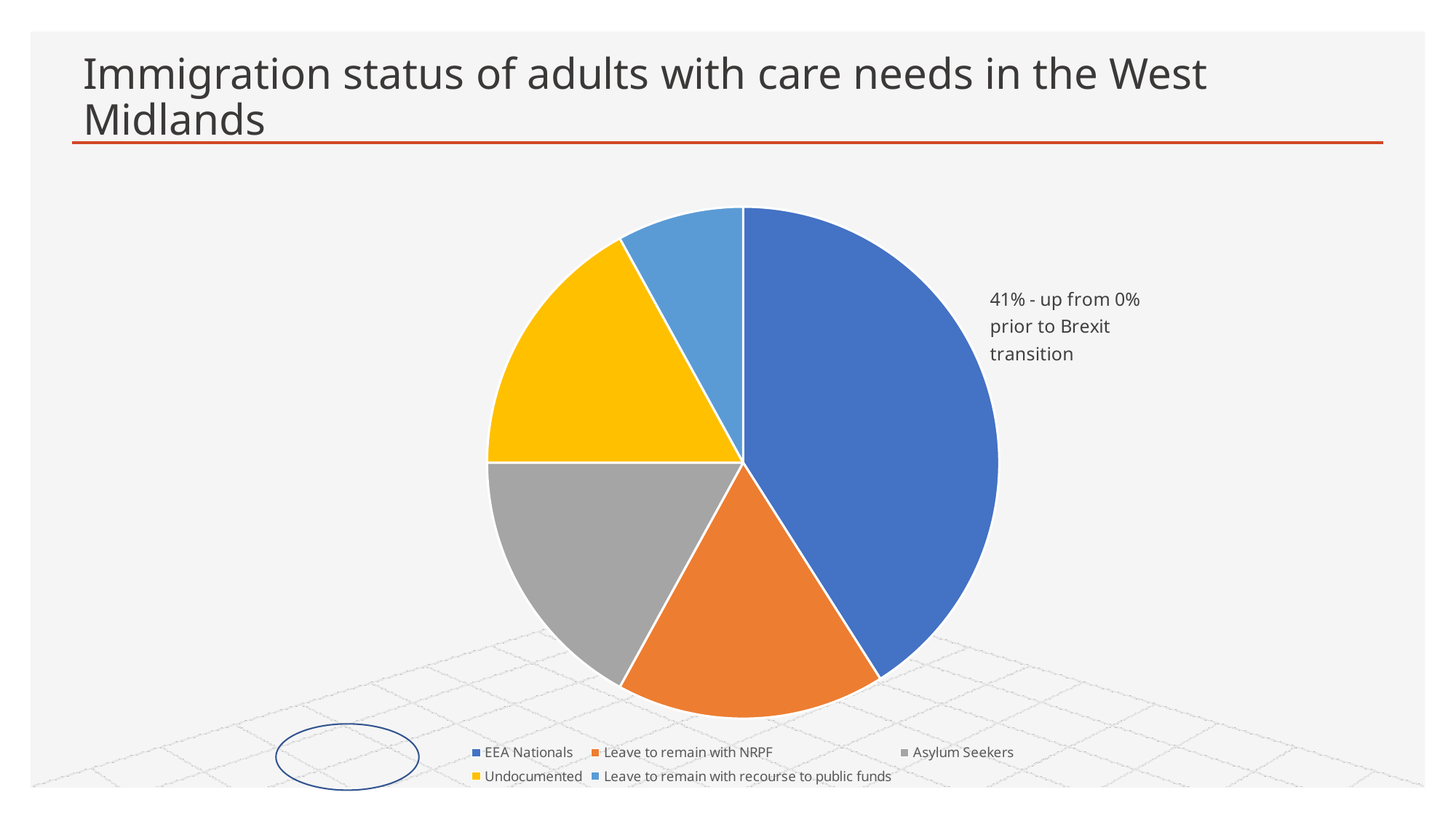
What value is printed next to the EEA Nationals slice? 41% What kind of chart is shown on the slide? Pie chart Which slice is larger: EEA Nationals or Undocumented? EEA Nationals What is the title of the slide containing the pie chart? Immigration status of adults with care needs in the West Midlands Which slice is larger: Asylum Seekers or Leave to remain with recourse to public funds? Asylum Seekers How many entries does the legend of the pie chart list? 5 What share of the pie is EEA Nationals? 41% Which category has the largest slice of the pie? EEA Nationals Which category has the smallest slice of the pie? Leave to remain with recourse to public funds How many slices does the pie chart have? 5 According to the annotation, what was the EEA Nationals share prior to the Brexit transition? 0%